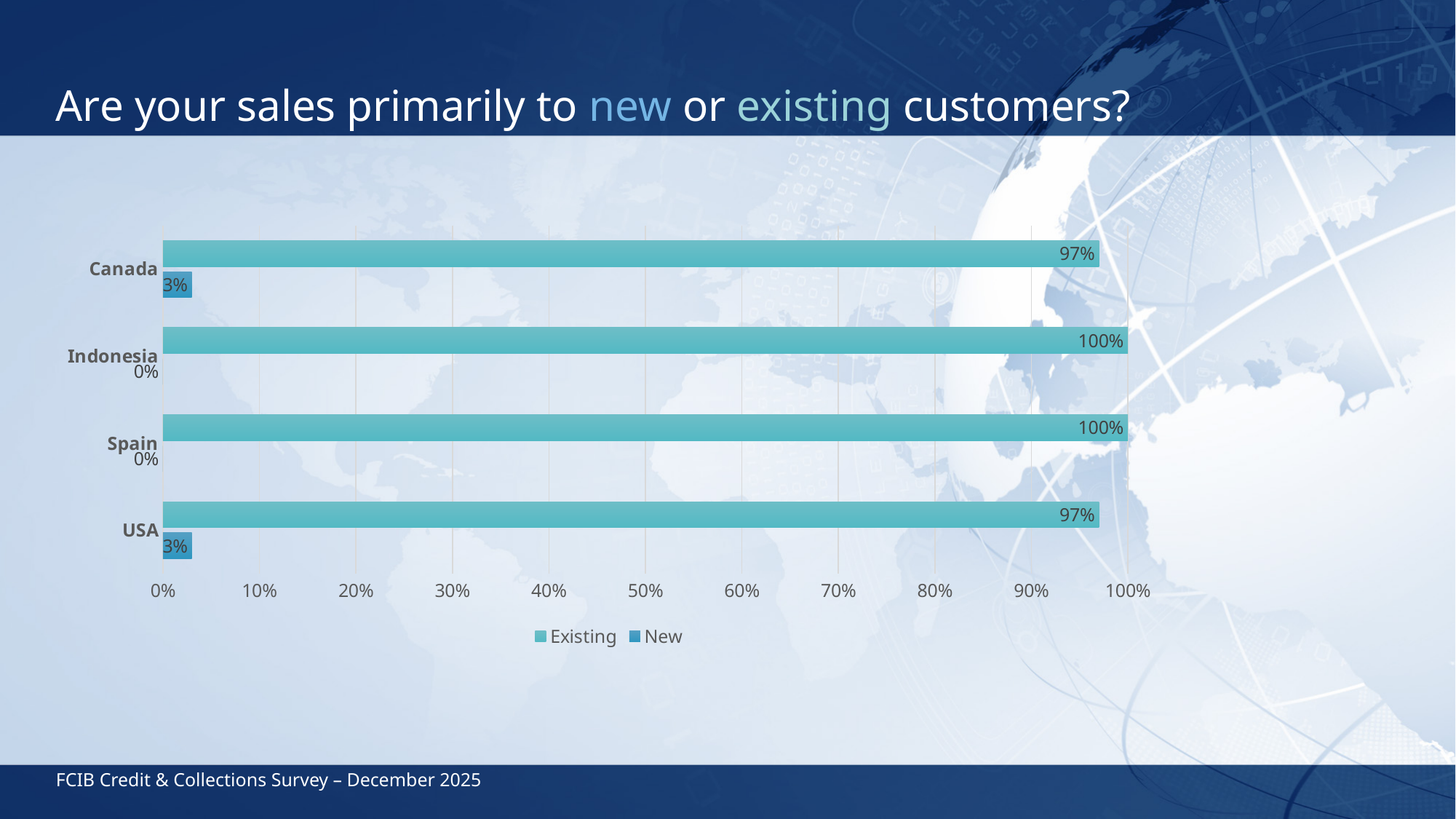
Which countries have the lowest share of sales to existing customers? Canada and USA What are the two series named in the legend? Existing and New Which countries have the highest share of sales to existing customers? Indonesia and Spain What type of chart is shown on the slide? Bar chart How many series does the legend list? 2 What percentage of Indonesia's sales are to new customers? 0% How many countries are shown on the chart? 4 Is the Existing value for Indonesia larger or smaller than the Existing value for the USA? larger What percentage of Canada's sales are to existing customers? 97% What is the value for New customers for the USA? 3% What is the difference between Canada's Existing and New customer percentages? 94% What is the Existing customers value for Spain? 100%